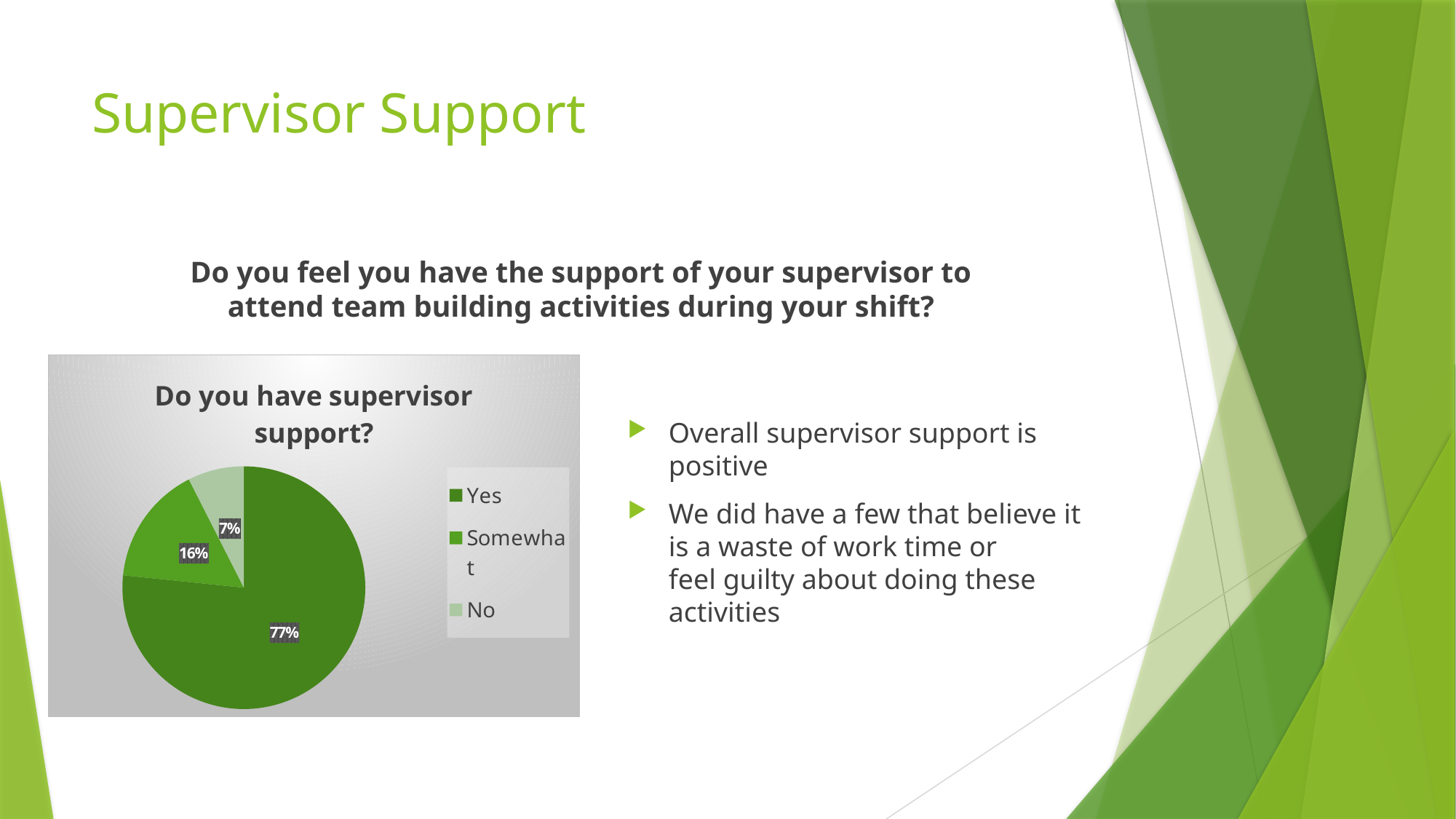
What is the difference in percentage points between the Yes and Somewhat slices? 61 Which is larger, the Somewhat slice or the No slice? Somewhat What is the difference in percentage points between the Somewhat and No slices? 9 What are the three entries listed in the legend? Yes, Somewhat, No How many slices does the pie chart have? 3 What kind of chart is shown on the slide? pie chart What is the chart's title? Do you have supervisor support? What percentage of respondents answered Yes? 77% Which response has the smallest share of the pie? No What percentage of respondents answered No? 7% What percentage of respondents answered Somewhat? 16% Which response has the largest share of the pie? Yes